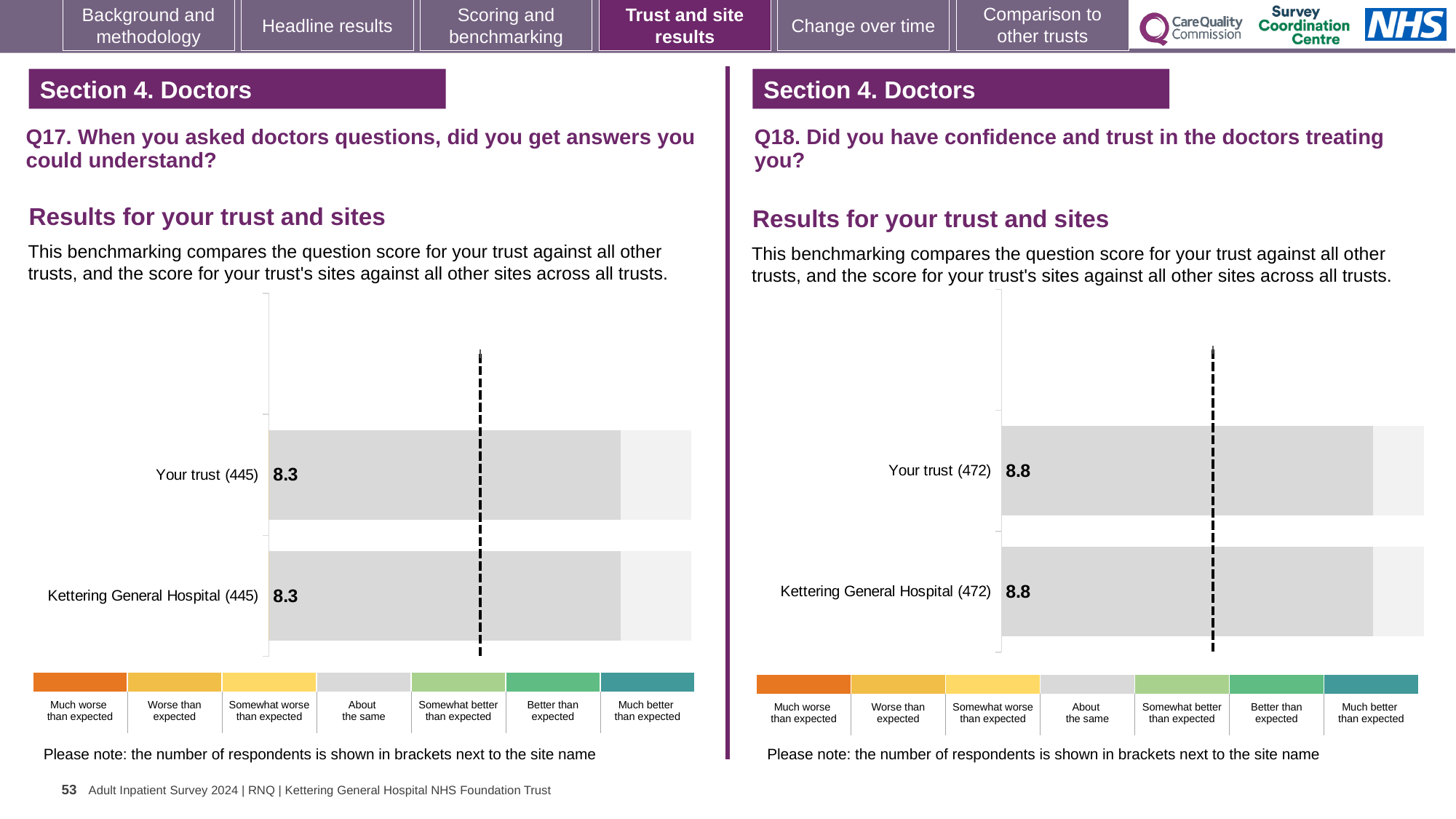
How many bars are plotted on the Q17 chart (left)? 2 On the Q18 chart (right), how many respondents are shown in brackets next to Kettering General Hospital? 472 On the Q18 chart (right), what is the difference between the Your trust score and the Kettering General Hospital score? 0 On the Q18 chart (right), what is the score for Kettering General Hospital? 8.8 On the Q18 chart (right), what is the score for Your trust? 8.8 On the Q17 chart (left), what is the score for Your trust? 8.3 On the Q17 chart (left), what is the score for Kettering General Hospital? 8.3 On the Q17 chart (left), what is the difference between the Your trust score and the Kettering General Hospital score? 0 What kind of chart is used on the Q18 chart (right)? Bar chart On the Q17 chart (left), how many respondents are shown in brackets next to Your trust? 445 Which is larger: the Your trust score on the Q17 chart (left) or the Your trust score on the Q18 chart (right)? Q18 chart (8.8) How many bars are plotted on the Q18 chart (right)? 2